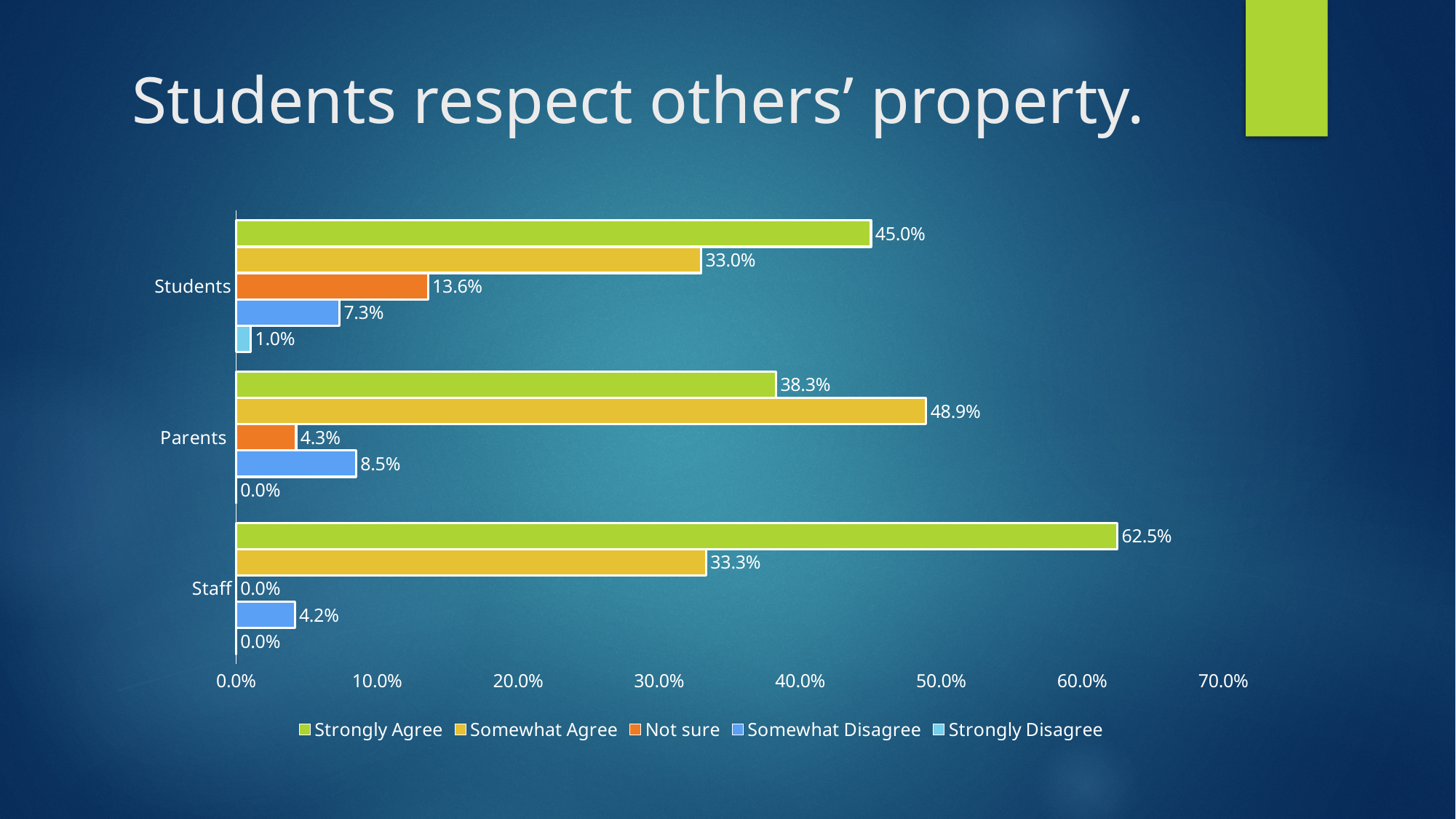
What percentage of Parents responded Somewhat Agree? 48.9% Which group has the highest Strongly Agree percentage? Staff What percentage of Students responded Not sure? 13.6% Which is larger for Parents: Strongly Agree or Somewhat Agree? Somewhat Agree Which group has the lowest Somewhat Agree percentage? Students What is the title of the slide? Students respect others' property. What is the difference between the Staff and Students Strongly Agree percentages? 17.5% How many series does the legend list? 5 What percentage of Staff responded Strongly Agree? 62.5% How many groups are shown on the vertical axis? 3 What percentage of Students responded Strongly Agree? 45.0% What kind of chart is shown on the slide? Bar chart